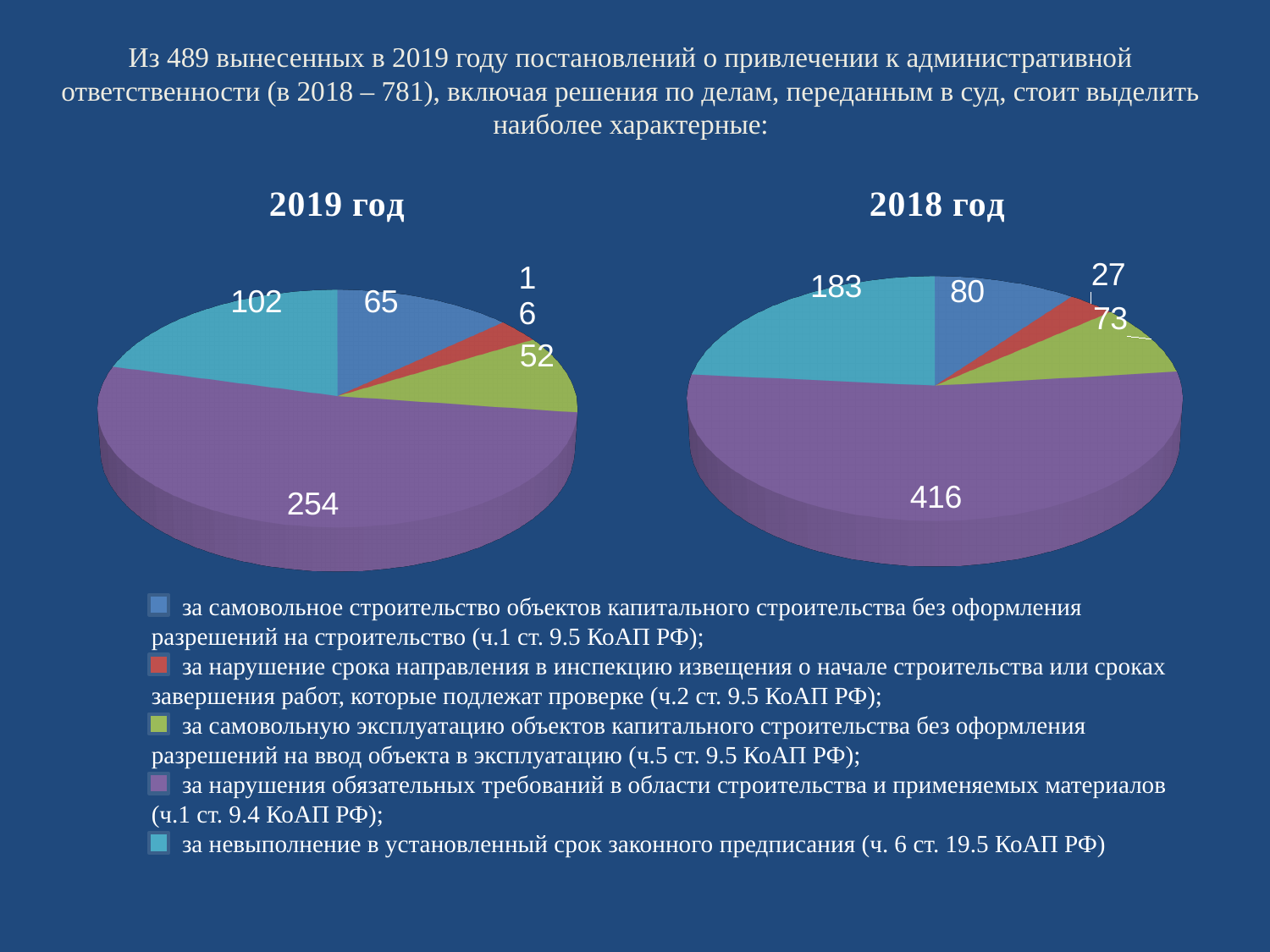
In the "2019 год" chart, which is larger: the value for ч. 6 ст. 19.5 КоАП РФ or the value for ч.1 ст. 9.5 КоАП РФ? ч. 6 ст. 19.5 КоАП РФ In the "2019 год" chart, what is the value for unauthorized operation of facilities without a commissioning permit (ч.5 ст. 9.5 КоАП РФ)? 52 What is the title of the chart on the left side of the slide? 2019 год In the "2018 год" chart, what is the difference between the values for ч.1 ст. 9.5 КоАП РФ and ч.5 ст. 9.5 КоАП РФ? 7 In the "2018 год" chart, what is the value for failure to comply with a lawful order in time (ч. 6 ст. 19.5 КоАП РФ)? 183 What kind of chart is used for the "2019 год" chart? pie chart In the "2018 год" chart, which category has the smallest slice? за нарушение срока направления в инспекцию извещения (ч.2 ст. 9.5 КоАП РФ) In the "2019 год" chart, which category has the largest slice? за нарушения обязательных требований в области строительства и применяемых материалов (ч.1 ст. 9.4 КоАП РФ) How much larger is the value for ч.1 ст. 9.4 КоАП РФ in the "2018 год" chart than in the "2019 год" chart? 162 In the "2018 год" chart, what is the value for unauthorized construction without a building permit (ч.1 ст. 9.5 КоАП РФ)? 80 In the "2019 год" chart, what is the value for violations of mandatory construction requirements (ч.1 ст. 9.4 КоАП РФ)? 254 How many slices does the "2018 год" pie chart have? 5